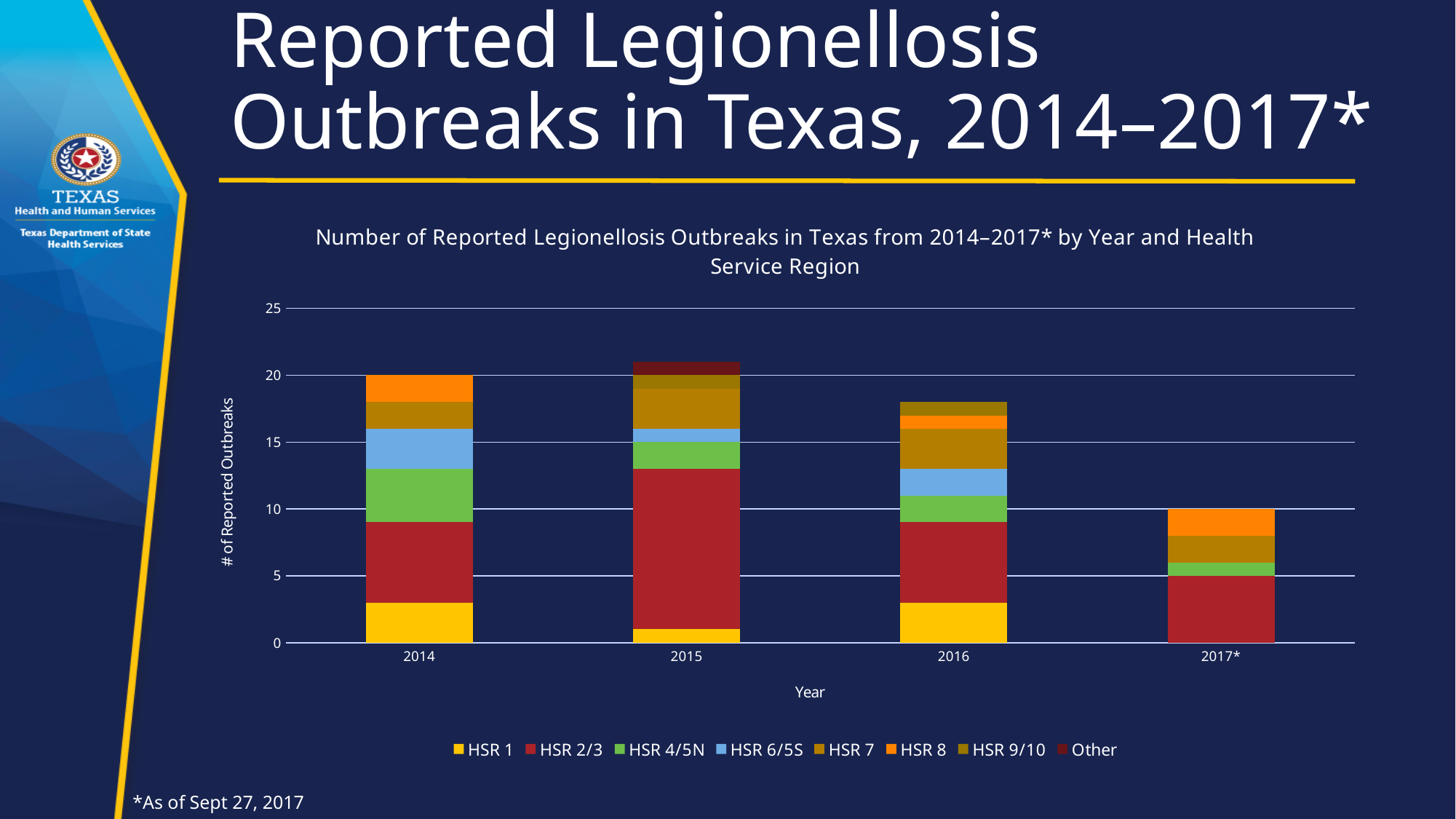
Is the total number of reported outbreaks for 2015 greater or less than 20? greater How many series does the chart's legend list? 8 What is the value for HSR 2/3 in 2017*? 5 Which year has the lowest total number of reported outbreaks? 2017* What is the label of the y axis? # of Reported Outbreaks What is the total number of reported outbreaks for 2017*? 10 What type of chart is shown on the slide? Stacked bar chart Is the total number of reported outbreaks for 2016 greater or less than 15? greater Which series is listed first in the legend? HSR 1 How many years are shown on the x axis of the chart? 4 What is the total number of reported outbreaks for 2014? 20 Which year has a larger total of reported outbreaks, 2014 or 2017*? 2014